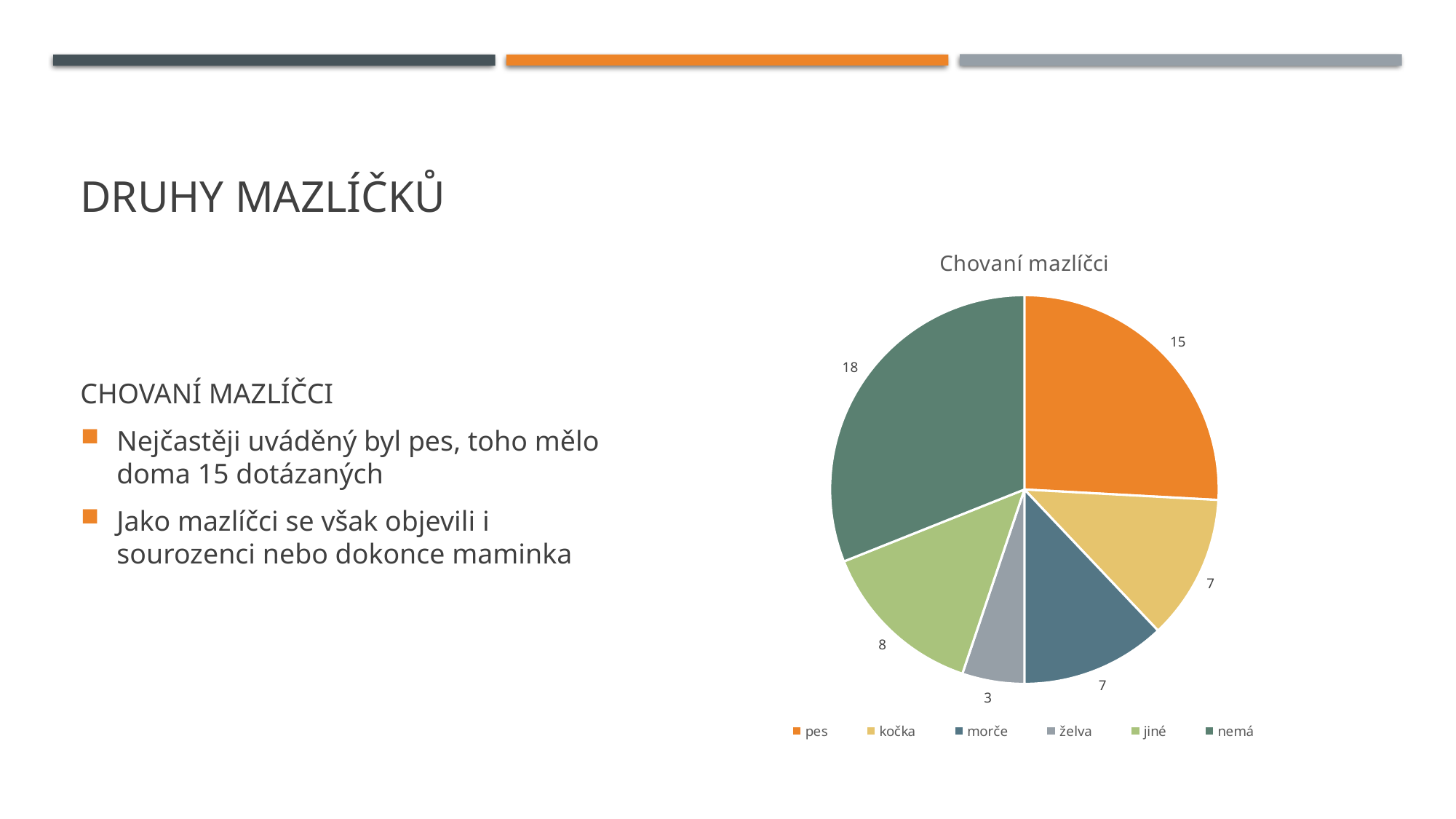
Which category has the largest slice in the pie chart? nemá Which category has the smallest slice in the pie chart? želva How many categories does the legend of the pie chart list? 6 What is the total of all the values shown in the pie chart? 58 What is the title of the chart? Chovaní mazlíčci What type of chart is shown on the slide? pie chart Which is larger, the value for jiné or the value for kočka? jiné What is the value for pes in the pie chart? 15 What is the value for želva in the pie chart? 3 What is the value for nemá in the pie chart? 18 What is the difference between the values for nemá and pes? 3 What is the value for jiné in the pie chart? 8